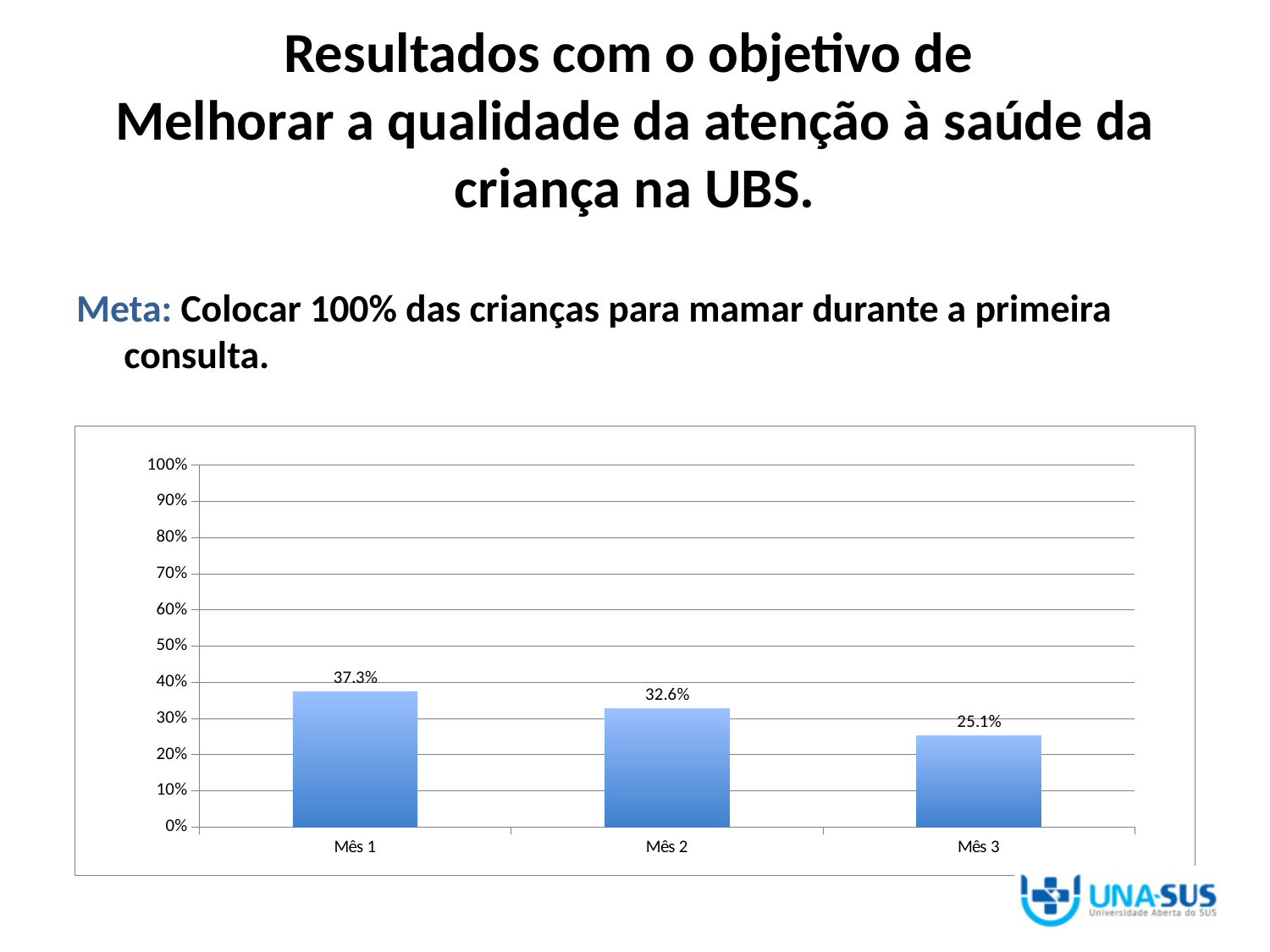
What is the difference between the values for Mês 2 and Mês 3? 7.5% Is the value for Mês 3 greater or less than 30%? less Which month has the lowest value? Mês 3 What is the value for Mês 2? 32.6% Which month has the highest value? Mês 1 What is the value for Mês 3? 25.1% What kind of chart is shown on the slide? bar chart Which is larger, the value for Mês 1 or the value for Mês 2? Mês 1 How many months are shown on the x axis? 3 Do the values rise or fall from Mês 1 to Mês 3? fall What is the value for Mês 1? 37.3% What is the difference between the values for Mês 1 and Mês 3? 12.2%